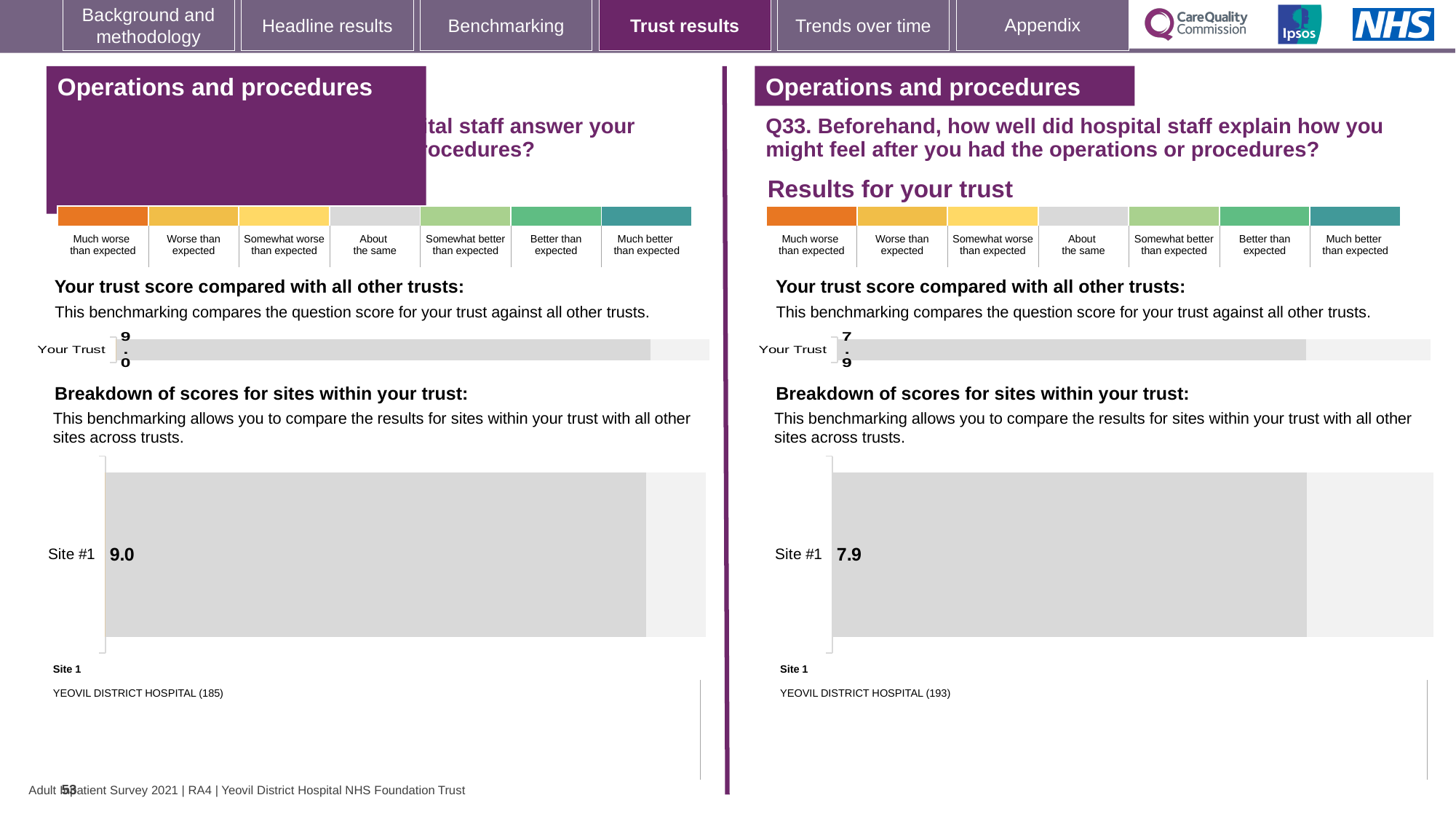
On the left panel, what score is shown for Site #1 in the 'Breakdown of scores for sites within your trust' chart? 9.0 How many sites are shown in the 'Breakdown of scores for sites within your trust' chart on the right panel (Q33)? 1 On the left panel, what is the score shown for Your Trust in the 'Your trust score compared with all other trusts' chart? 9.0 On the right panel (Q33), which site name is listed as Site 1 below the breakdown chart? YEOVIL DISTRICT HOSPITAL (193) On the right panel (Q33), what score is shown for Site #1 in the 'Breakdown of scores for sites within your trust' chart? 7.9 What type of chart is used to show the Your Trust score on the left panel? Bar chart On the right panel (Q33), what is the score shown for Your Trust in the 'Your trust score compared with all other trusts' chart? 7.9 On the right panel (Q33), is the Site #1 score greater or less than the Your Trust score on the left panel? less On the left panel, which site name is listed as Site 1 below the breakdown chart? YEOVIL DISTRICT HOSPITAL (185) Which is larger: the Your Trust score on the left panel or the Your Trust score on the right panel (Q33)? Left panel (9.0) What type of chart is used for the 'Breakdown of scores for sites within your trust' on the right panel (Q33)? Bar chart What is the difference between the Site #1 score on the left panel and the Site #1 score on the right panel (Q33)? 1.1